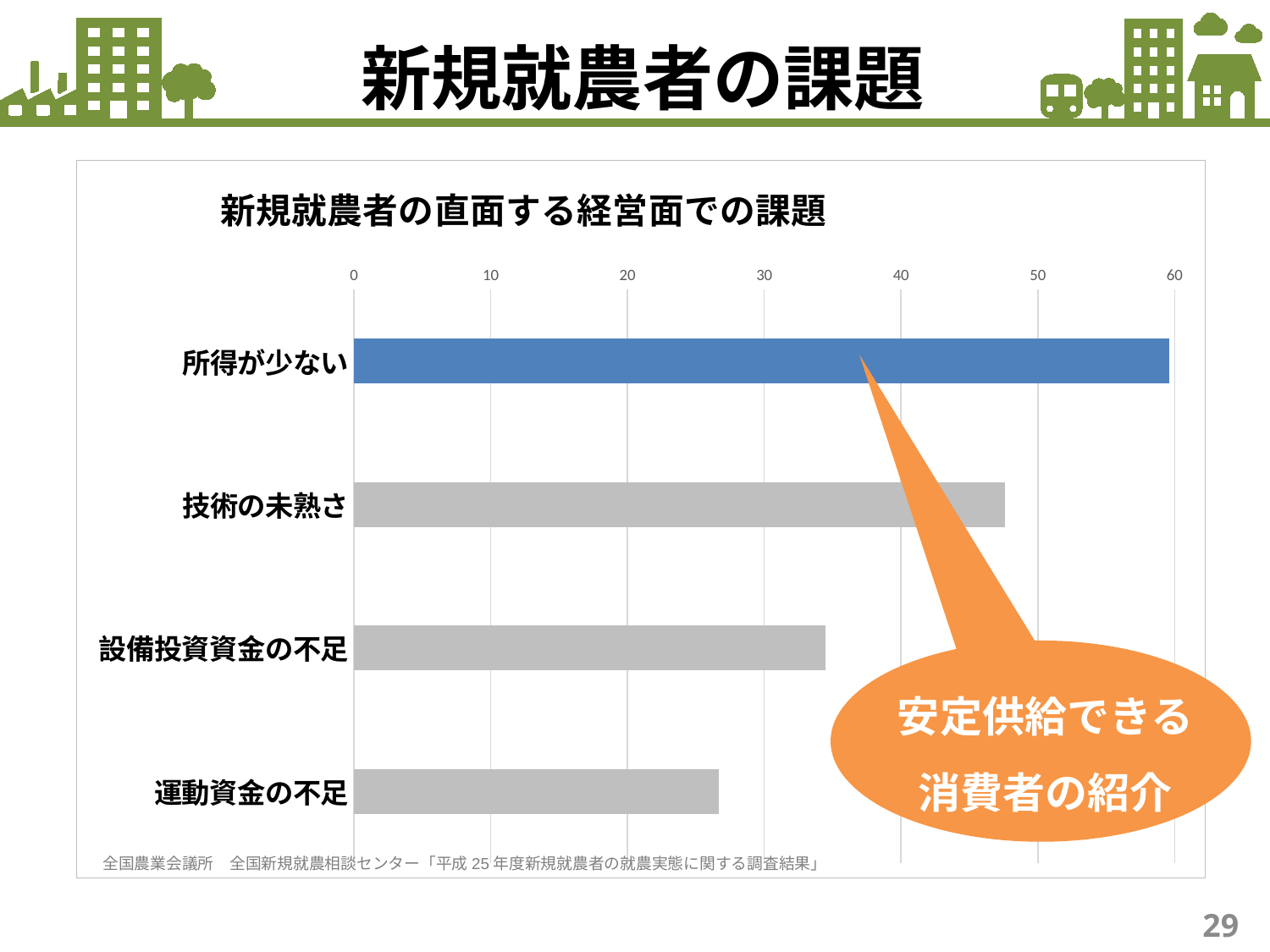
Is the value for 所得が少ない greater or less than 50? greater Do the bar values rise or fall going from the top category to the bottom category? fall Is the value for 運動資金の不足 greater or less than 30? less What kind of chart is shown on the slide? bar chart Which is larger, the value for 技術の未熟さ or the value for 設備投資資金の不足? 技術の未熟さ Is the value for 技術の未熟さ greater or less than 40? greater Which category's bar is coloured blue rather than grey? 所得が少ない What is the title of the chart? 新規就農者の直面する経営面での課題 How many categories are plotted in the chart? 4 Which category has the highest value? 所得が少ない Which category has the lowest value? 運動資金の不足